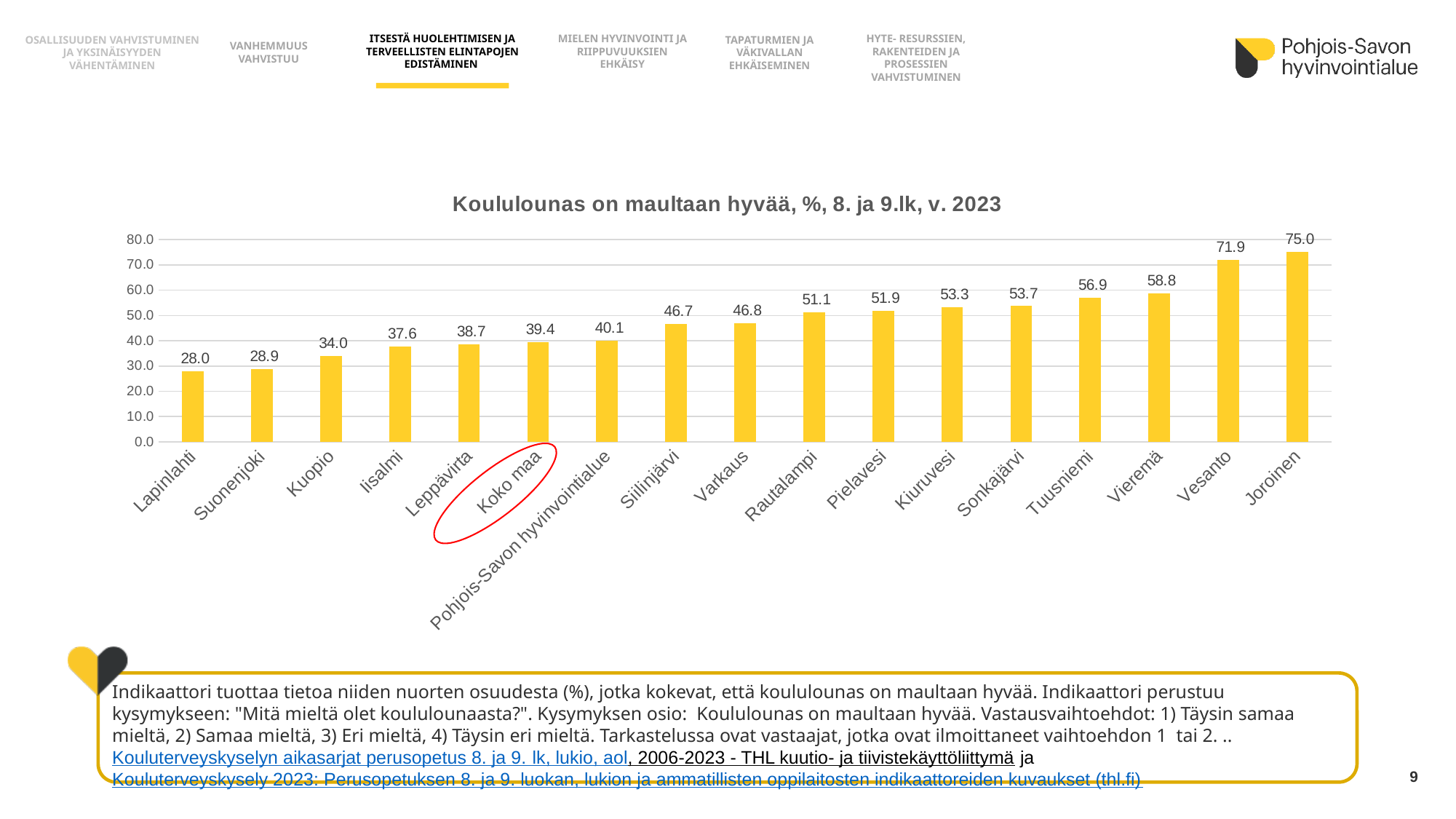
How many categories are shown on the x axis? 17 What kind of chart is shown on the slide? bar chart What is the difference between the values for Joroinen and Lapinlahti? 47.0 What is the value for Kuopio? 34.0 What is the value for Pohjois-Savon hyvinvointialue? 40.1 Which category has the lowest value? Lapinlahti What is the difference between the values for Vesanto and Vieremä? 13.1 Which is larger, the value for Tuusniemi or the value for Kiuruvesi? Tuusniemi Which category has the highest value? Joroinen What is the value for Koko maa? 39.4 Is the value for Rautalampi greater or less than 50.0? greater Do the values rise or fall from left to right along the x axis? rise